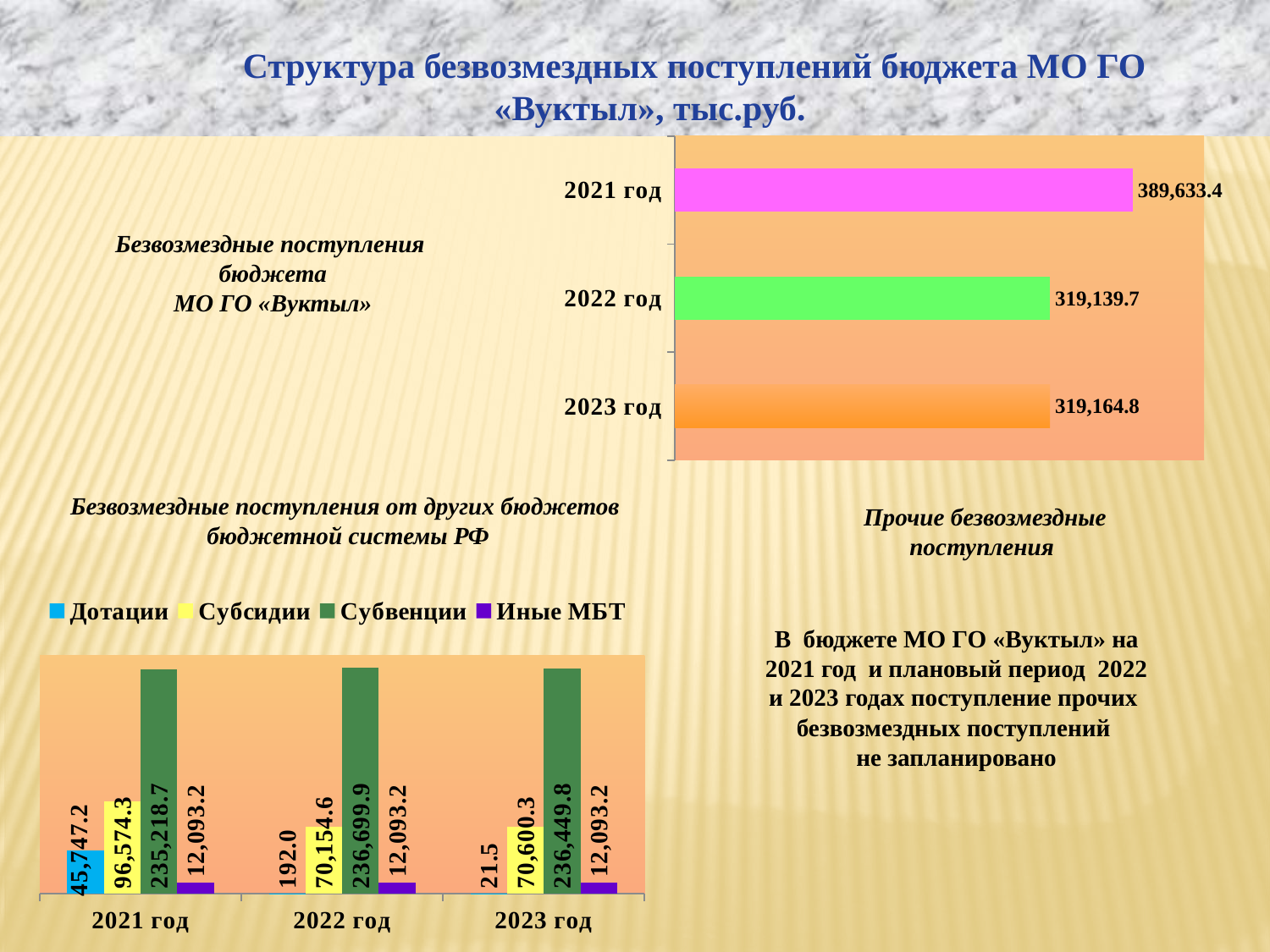
In the bottom-left chart, how many series does the legend list? 4 In the top-right chart, what is the difference between the values for 2021 год and 2022 год? 70,493.7 In the bottom-left chart, which is larger: Дотации in 2021 год or Дотации in 2022 год? Дотации in 2021 год In the bottom-left chart, what is the value of Субвенции for 2022 год? 236,699.9 In the bottom-left chart, which series has the highest value in 2021 год? Субвенции In the top-right chart, how many bars are plotted? 3 What kind of chart is the top-right chart? bar chart In the top-right chart, what is the value for 2023 год? 319,164.8 In the bottom-left chart, what is the difference between Субсидии in 2021 год and 2022 год? 26,419.7 In the top-right chart, what is the value for 2021 год? 389,633.4 In the bottom-left chart, what is the value of Дотации for 2023 год? 21.5 In the top-right chart, which year has the highest value? 2021 год